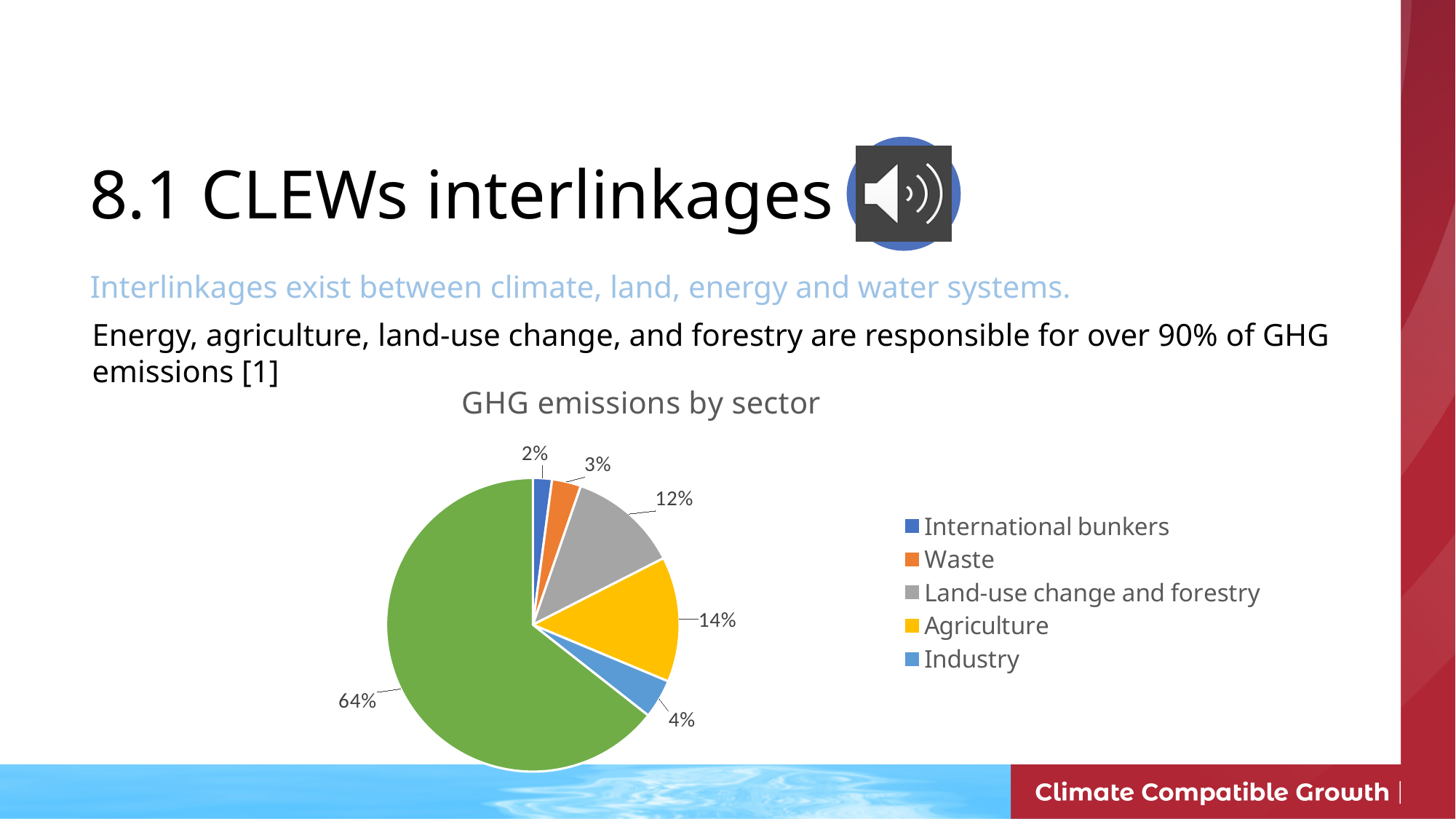
What share does Industry have in the pie chart? 4% What percentage is shown for Land-use change and forestry? 12% What percentage is labelled on the largest slice of the pie chart? 64% How many entries does the chart legend list? 5 Which has the larger share, Agriculture or Land-use change and forestry? Agriculture Which sector has the smallest slice in the pie chart? International bunkers What is the difference between the shares of Land-use change and forestry and Waste? 9% How many percentage points larger is Agriculture's share than Industry's? 10% What share of GHG emissions does Agriculture account for in the pie chart? 14% What percentage of GHG emissions is attributed to International bunkers? 2% What type of chart is shown on the slide? Pie chart What is the share for Waste in the GHG emissions by sector chart? 3%